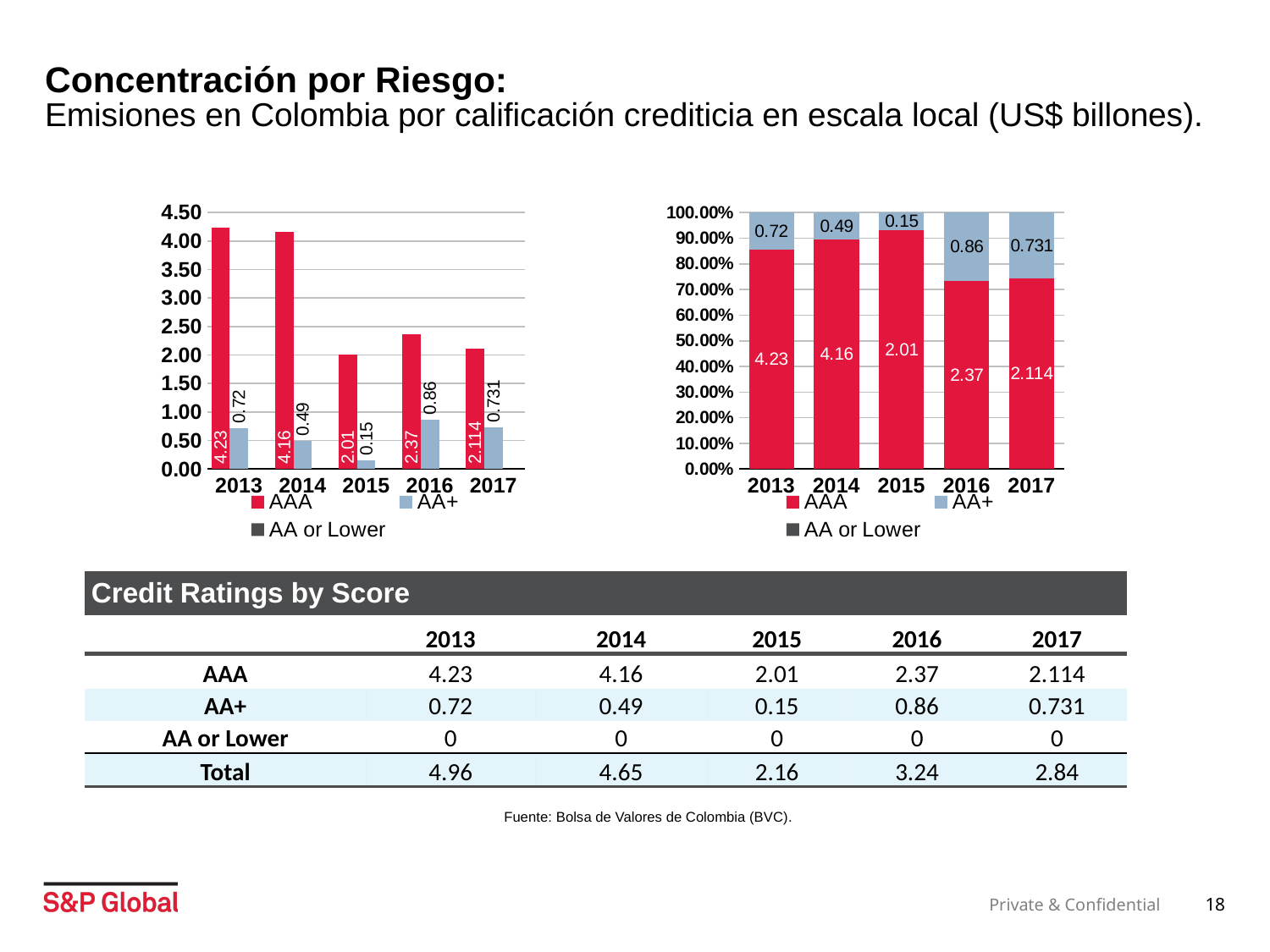
In the left chart, is the AAA value for 2014 greater or less than 4.00? greater What kind of chart is the right chart? stacked bar chart How many series does the legend of the right chart list? 3 In the left chart, what is the difference between the AAA values for 2013 and 2014? 0.07 In the left chart, which year has the highest AAA value? 2013 How many years are shown on the x axis of the left chart? 5 In the right chart, what is the AA+ label shown for 2015? 0.15 In the left chart, what is the AAA value for 2013? 4.23 In the left chart, is the AAA value for 2016 larger or smaller than the AAA value for 2015? larger In the left chart, what is the AAA value for 2017? 2.114 In the left chart, what is the AA+ value for 2016? 0.86 In the left chart, which year has the lowest AA+ value? 2015